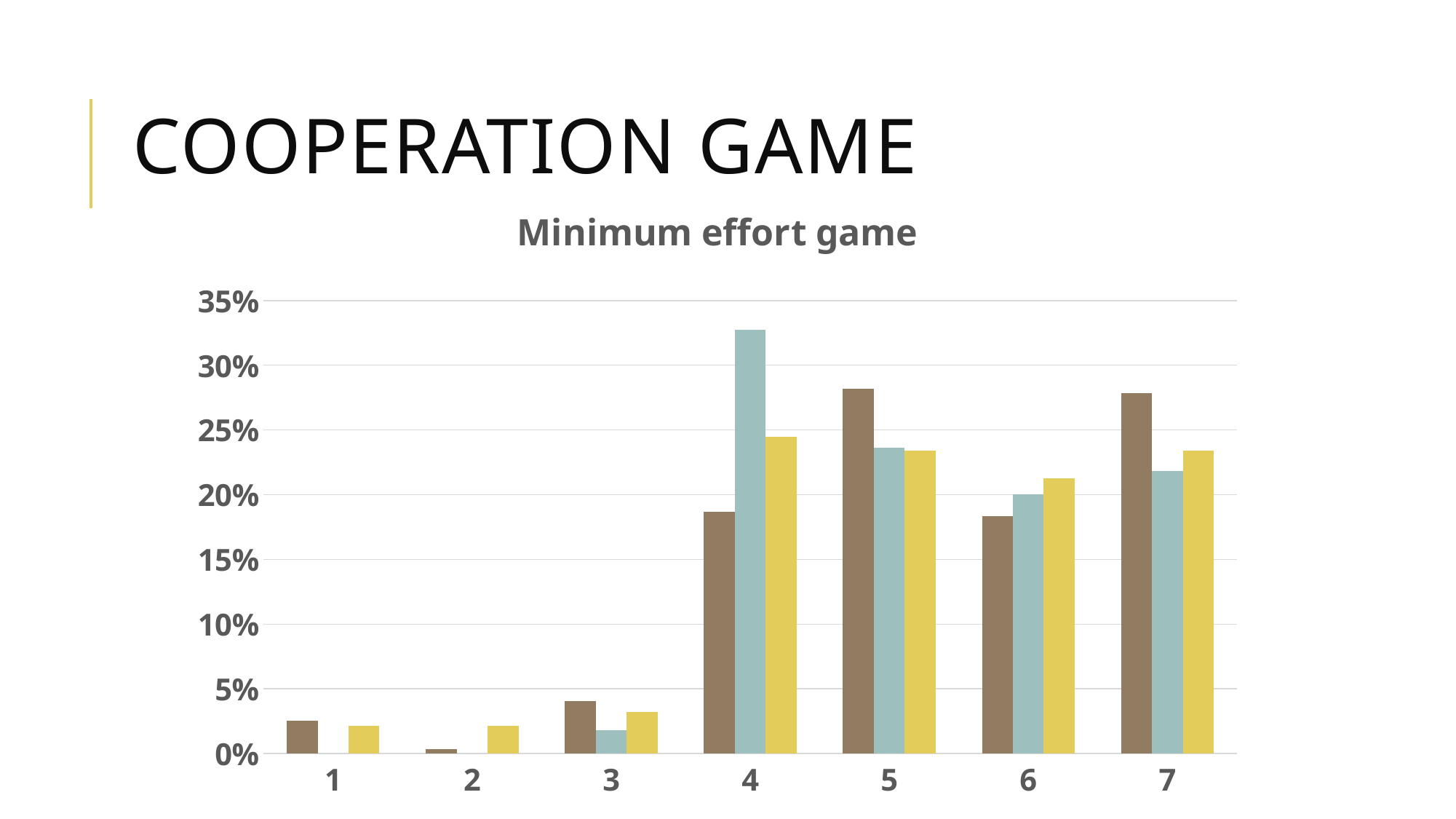
Is the value of the brown bar for category 4 greater or less than 20%? less For category 7, which is taller: the brown bar or the yellow bar? brown Is the value of the brown bar for category 1 greater or less than 5%? less What kind of chart is shown on the slide? bar chart What is the title of the chart? Minimum effort game How many categories are shown on the x axis of the chart? 7 How many differently coloured bar series are plotted in the chart? 3 Is the value of the teal bar for category 4 greater or less than 30%? greater Which category contains the tallest bar in the chart? 4 For category 4, which is taller: the teal bar or the brown bar? teal